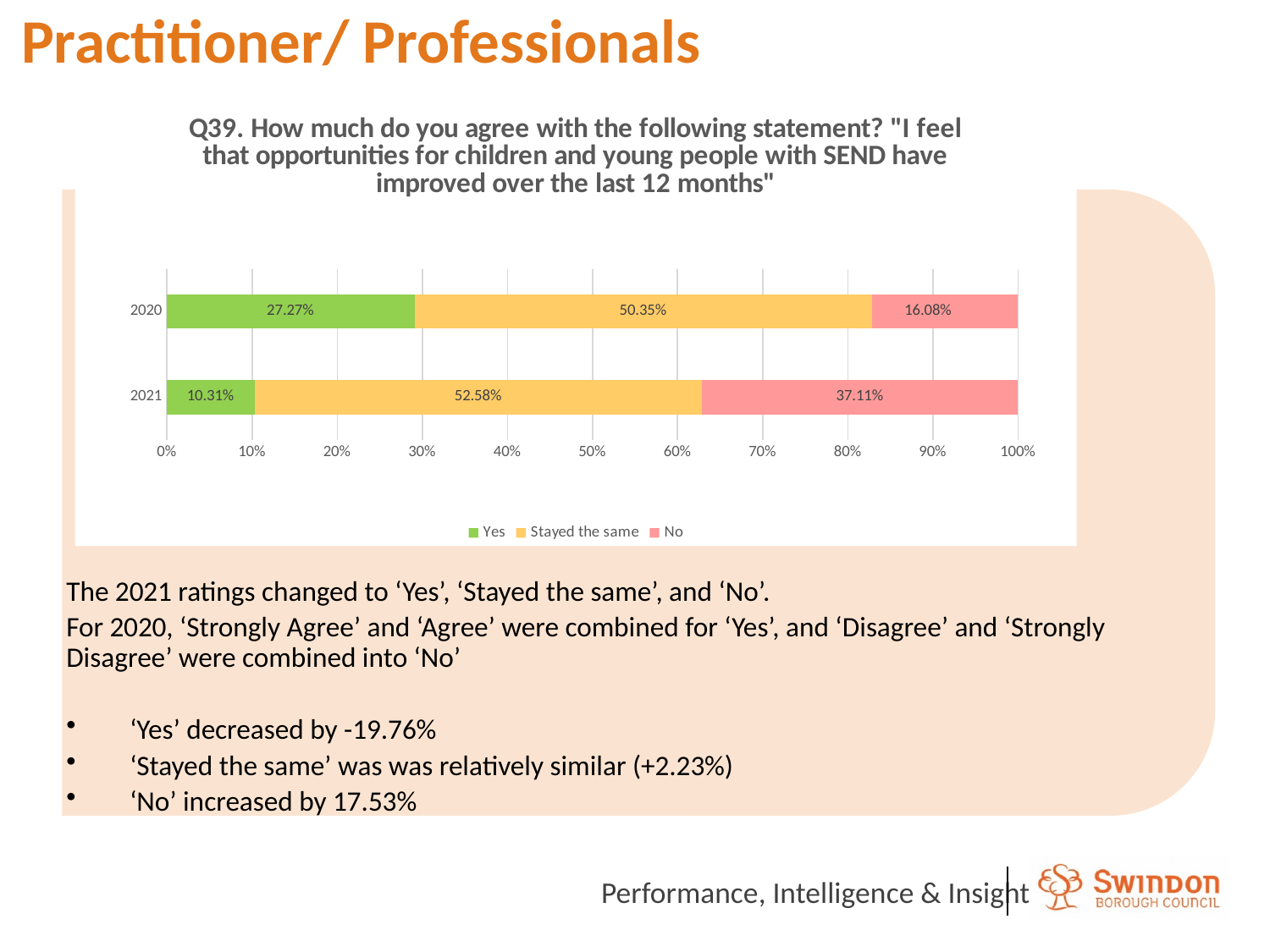
What kind of chart is shown? Stacked bar chart How many years are shown on the chart? 2 Which colour represents 'Stayed the same' in the chart? Yellow Which year has the higher value for 'Yes'? 2020 What is the difference between the 'No' values for 2021 and 2020? 21.03% Which year has the higher value for 'No'? 2021 What is the difference between the 'Yes' values for 2020 and 2021? 16.96% How many series does the legend list? 3 What is the value for 'No' in 2021? 37.11% What is the value for 'Yes' in 2020? 27.27% What is the value for 'Stayed the same' in 2021? 52.58% What is the value for 'No' in 2020? 16.08%